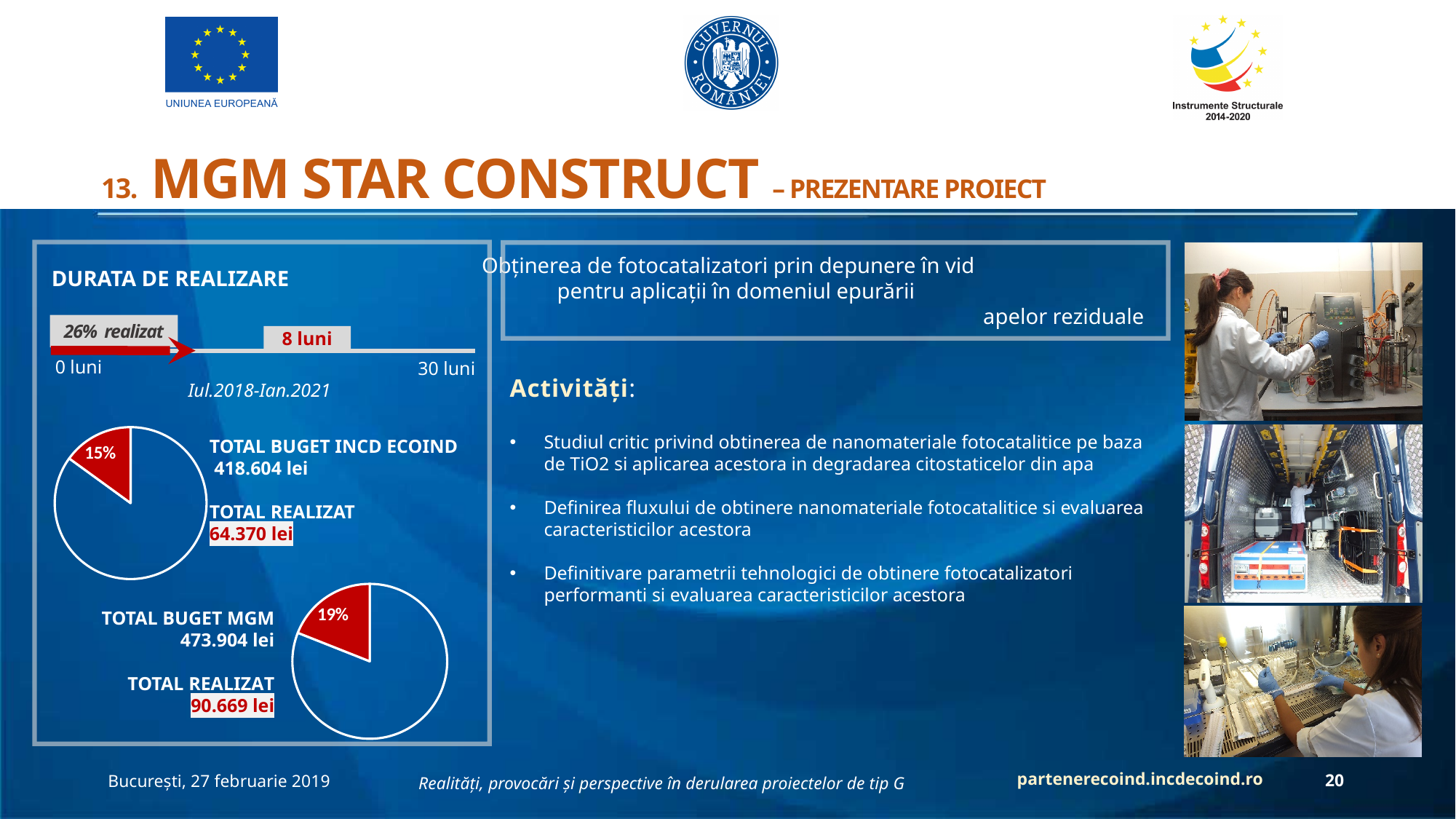
How many slices does each pie chart on the slide have? 2 What is the TOTAL BUGET MGM shown next to the lower pie chart? 473.904 lei In the upper pie chart (TOTAL BUGET INCD ECOIND), what percentage does the red slice represent? 15% What is the TOTAL REALIZAT value shown for INCD ECOIND next to the upper pie chart? 64.370 lei What kind of chart is used to show the share of the INCD ECOIND budget realized? pie chart What is the TOTAL REALIZAT value shown for MGM next to the lower pie chart? 90.669 lei What colour is the slice representing the realized portion in both pie charts? red What is the difference between the TOTAL BUGET MGM and the TOTAL BUGET INCD ECOIND? 55.300 lei What is the TOTAL BUGET INCD ECOIND shown next to the upper pie chart? 418.604 lei In the lower pie chart (TOTAL BUGET MGM), what percentage does the red slice represent? 19% Which pie chart shows a larger realized share, the INCD ECOIND one or the MGM one? MGM Which partner has the larger total budget, INCD ECOIND or MGM? MGM